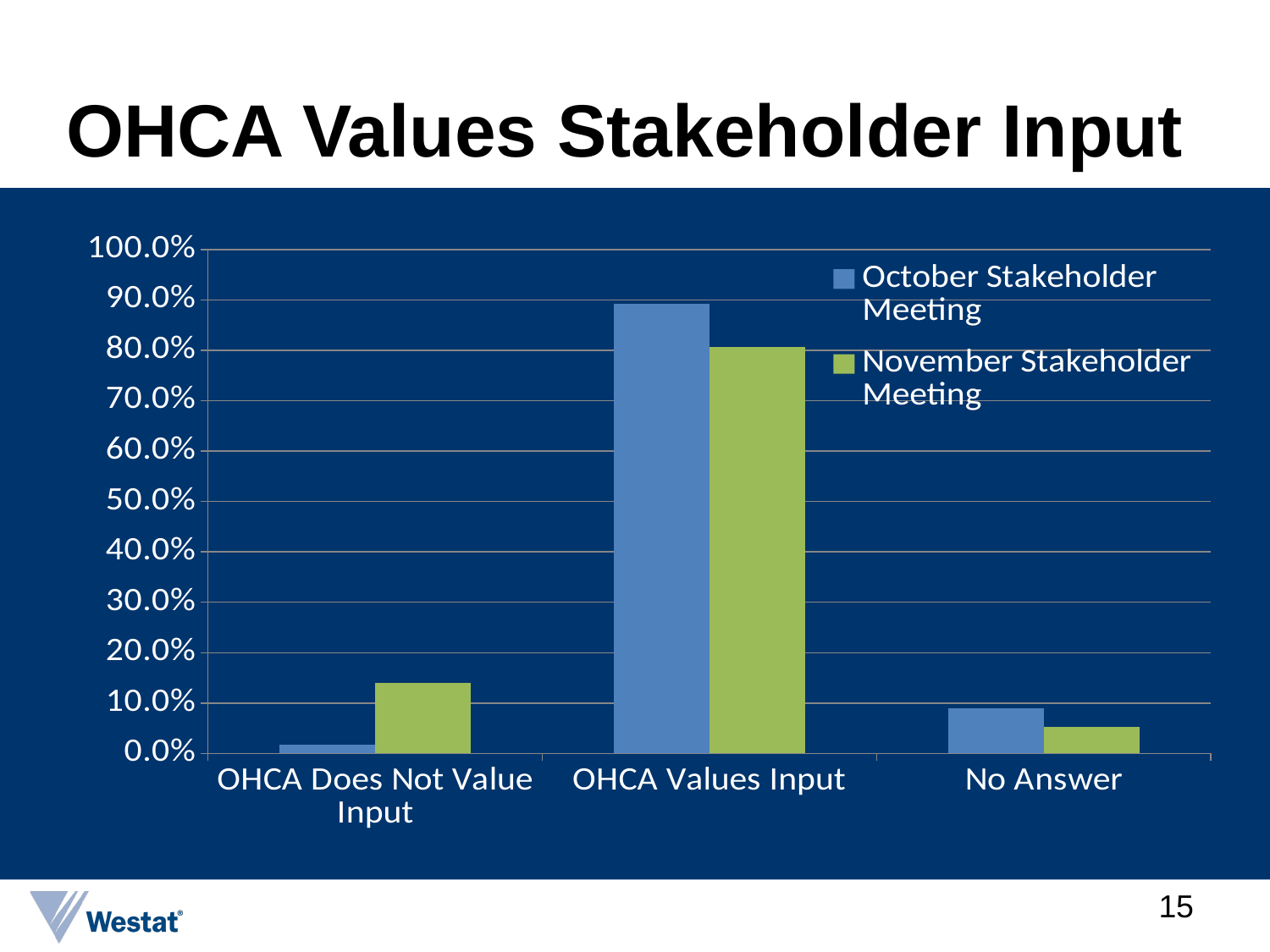
Which category has the highest value for the October Stakeholder Meeting? OHCA Values Input How many series does the legend list? 2 Which category has the lowest value for the October Stakeholder Meeting? OHCA Does Not Value Input Is the value for OHCA Does Not Value Input in the November Stakeholder Meeting greater or less than 20.0%? less How many categories are shown on the x axis? 3 For OHCA Values Input, which series has the larger value, October Stakeholder Meeting or November Stakeholder Meeting? October Stakeholder Meeting What is the title of the slide containing the chart? OHCA Values Stakeholder Input Is the value for OHCA Values Input in the October Stakeholder Meeting greater or less than 80.0%? greater Which category has the lowest value for the November Stakeholder Meeting? No Answer What kind of chart is shown on the slide? bar chart For OHCA Does Not Value Input, which series has the larger value, October Stakeholder Meeting or November Stakeholder Meeting? November Stakeholder Meeting Is the value for No Answer in the October Stakeholder Meeting greater or less than 20.0%? less